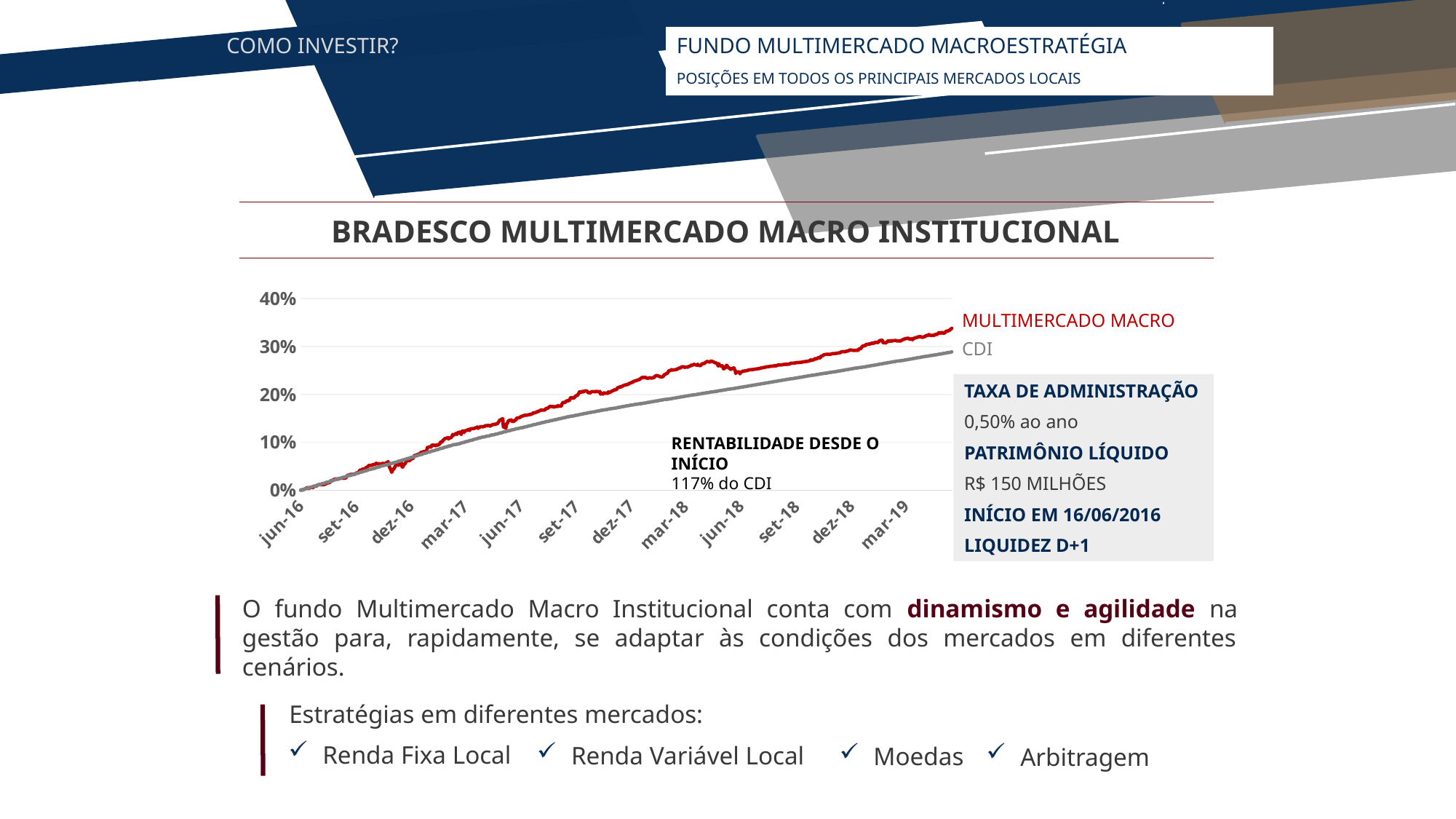
Is the value of the CDI line at dez-17 greater or less than 20%? less Is the value of the MULTIMERCADO MACRO line at mar-18 greater or less than 20%? greater Is the final value of the MULTIMERCADO MACRO line greater or less than 30%? greater Do the values of the MULTIMERCADO MACRO line rise or fall from jun-16 to mar-19? rise According to the annotation on the chart, what is the fund's return since inception as a percentage of the CDI? 117% do CDI What is the first date label on the x axis of the chart? jun-16 What kind of chart is shown on the slide? line chart Which series is higher at the end of the chart, MULTIMERCADO MACRO or CDI? MULTIMERCADO MACRO How many date labels are shown on the x axis of the chart? 12 How many series does the chart show? 2 What are the two series plotted on the chart? MULTIMERCADO MACRO and CDI